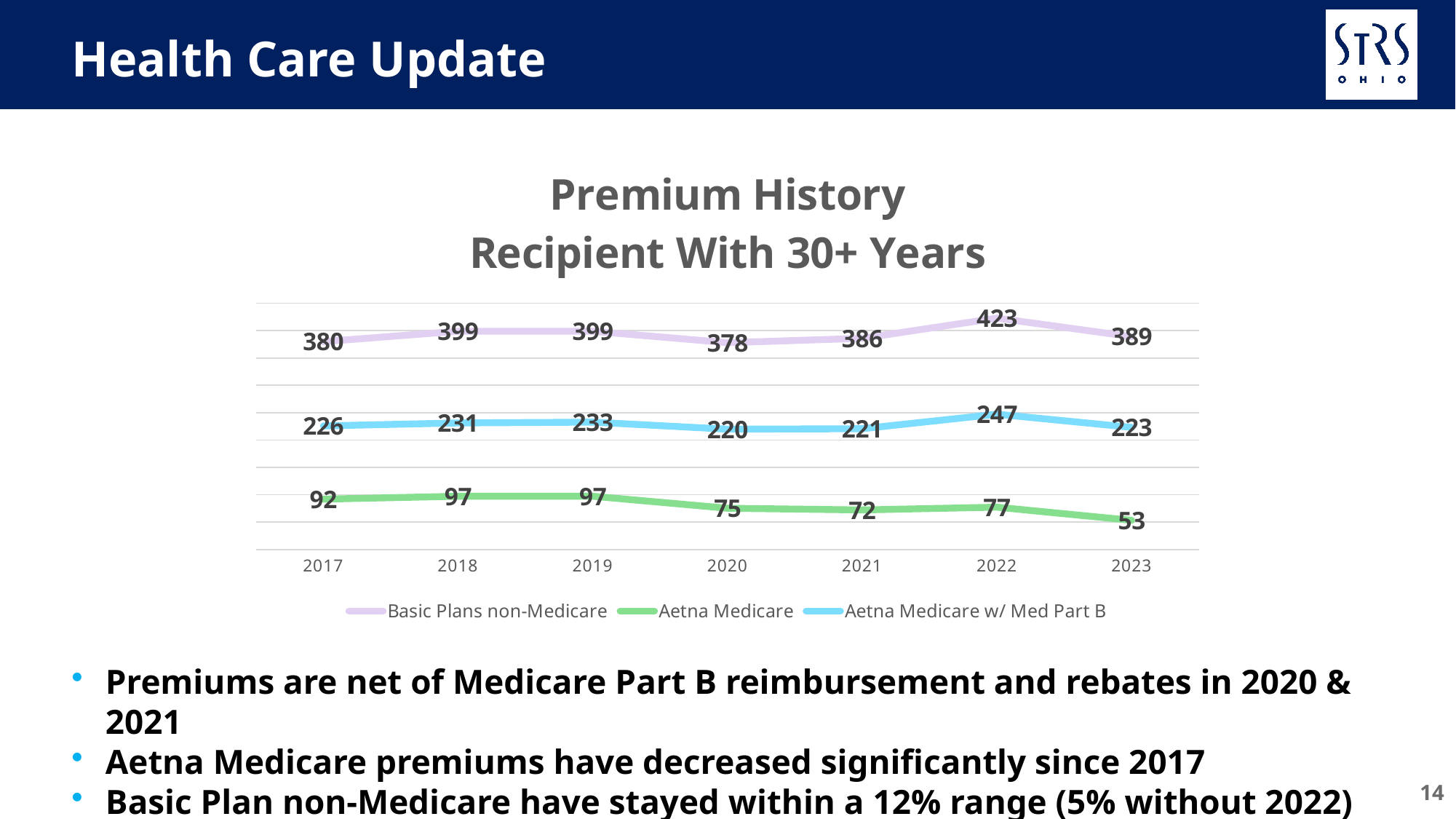
What is the difference between the Aetna Medicare premium in 2017 and in 2023? 39 In which year is the Aetna Medicare premium lowest? 2023 What is the title of the chart? Premium History Recipient With 30+ Years What is the Aetna Medicare premium in 2023? 53 What is the Basic Plans non-Medicare premium in 2022? 423 How many series does the legend list? 3 What kind of chart is shown on the slide? Line chart Which is larger: the Aetna Medicare w/ Med Part B premium in 2019 or in 2021? 2019 What is the Aetna Medicare w/ Med Part B premium in 2020? 220 How many years are shown on the x axis? 7 In which year is the Basic Plans non-Medicare premium highest? 2022 Does the Aetna Medicare premium rise or fall from 2019 to 2023? Fall